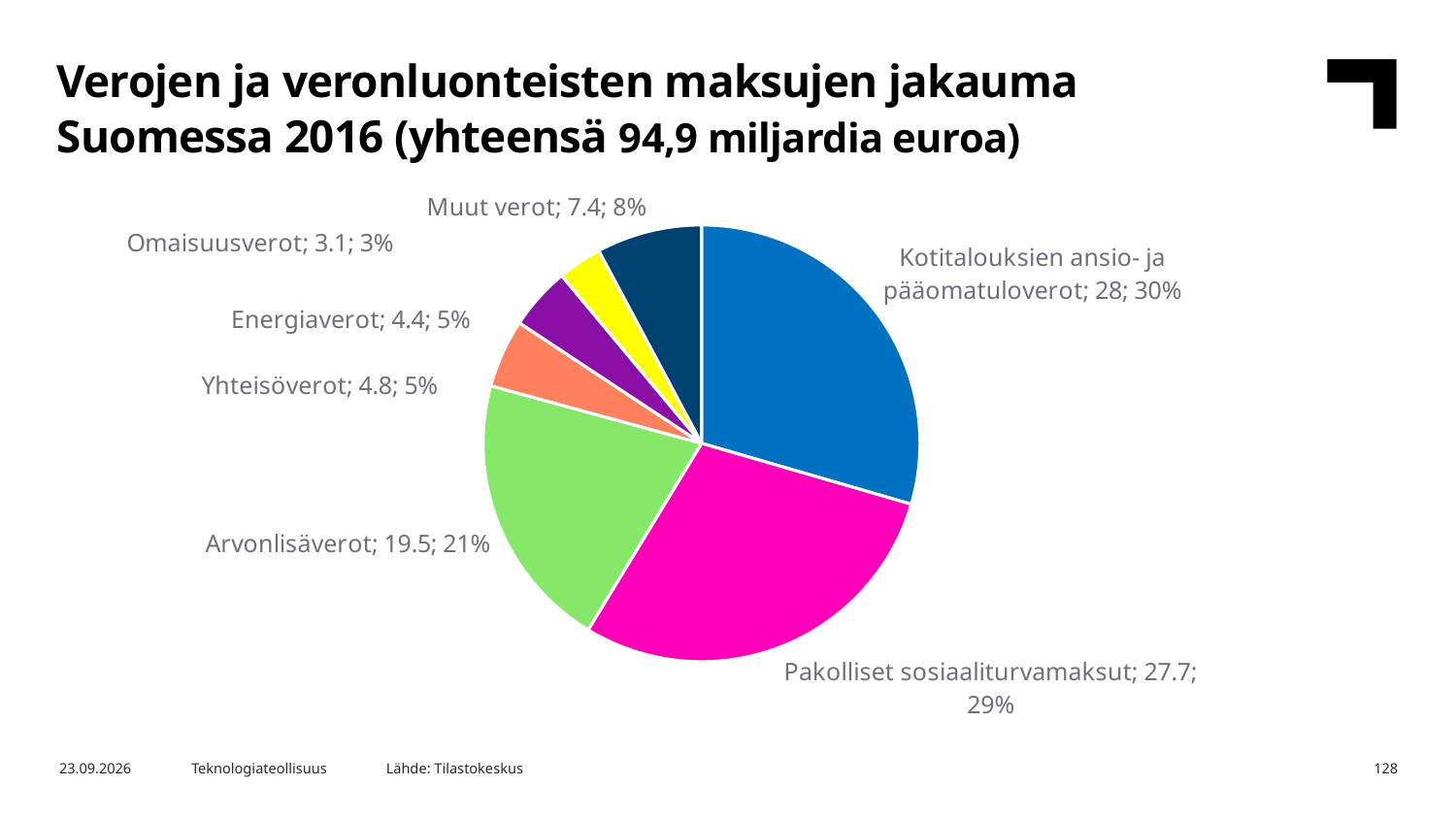
Which is larger, the value for Muut verot or the value for Yhteisöverot? Muut verot What is the value shown for Energiaverot? 4.4 Which category has the largest slice of the pie? Kotitalouksien ansio- ja pääomatuloverot What is the value shown for Arvonlisäverot? 19.5 How many slices does the pie chart have? 7 Which category has the smallest slice of the pie? Omaisuusverot What is the difference between the values for Arvonlisäverot and Yhteisöverot? 14.7 What share of the pie does Arvonlisäverot represent? 21% What share of the pie does Muut verot represent? 8% According to the chart title, what is the total amount of taxes and tax-like payments in Finland in 2016? 94,9 miljardia euroa What is the value shown for Pakolliset sosiaaliturvamaksut? 27.7 What kind of chart is shown on the slide? pie chart